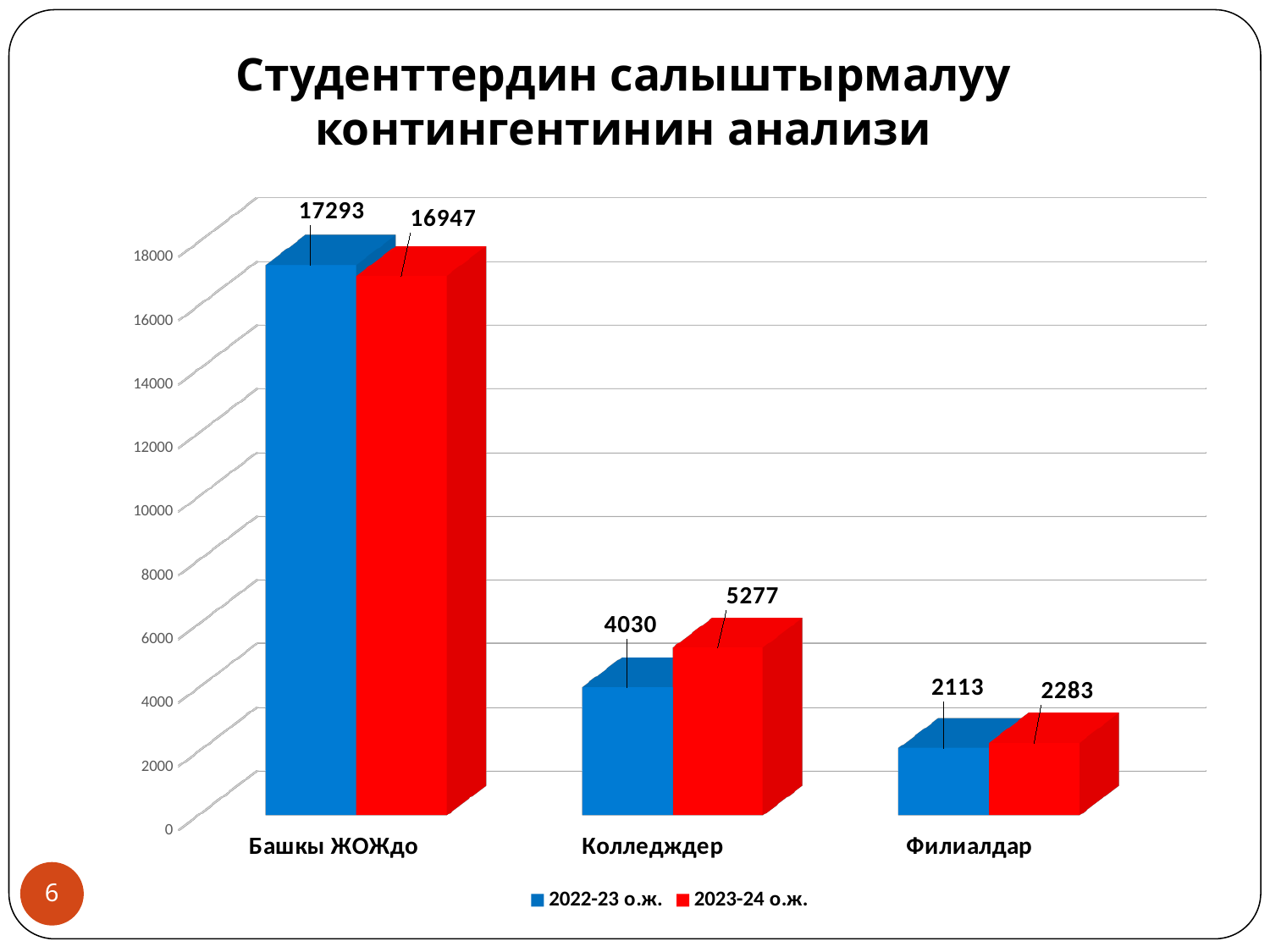
Which category has the highest value in the 2023-24 о.ж. series? Башкы ЖОЖдо What is the value for Филиалдар in the 2022-23 о.ж. series? 2113 How many series does the legend list? 2 What colour represents the 2023-24 о.ж. series? Red What is the value for Башкы ЖОЖдо in the 2022-23 о.ж. series? 17293 What is the difference between the 2023-24 о.ж. and 2022-23 о.ж. values for Колледждер? 1247 How many categories are shown on the x axis? 3 What is the value for Колледждер in the 2023-24 о.ж. series? 5277 Which category has the lowest value in the 2022-23 о.ж. series? Филиалдар For Филиалдар, which series has the larger value, 2022-23 о.ж. or 2023-24 о.ж.? 2023-24 о.ж. What kind of chart is shown on the slide? Bar chart What is the difference between the 2022-23 о.ж. and 2023-24 о.ж. values for Башкы ЖОЖдо? 346